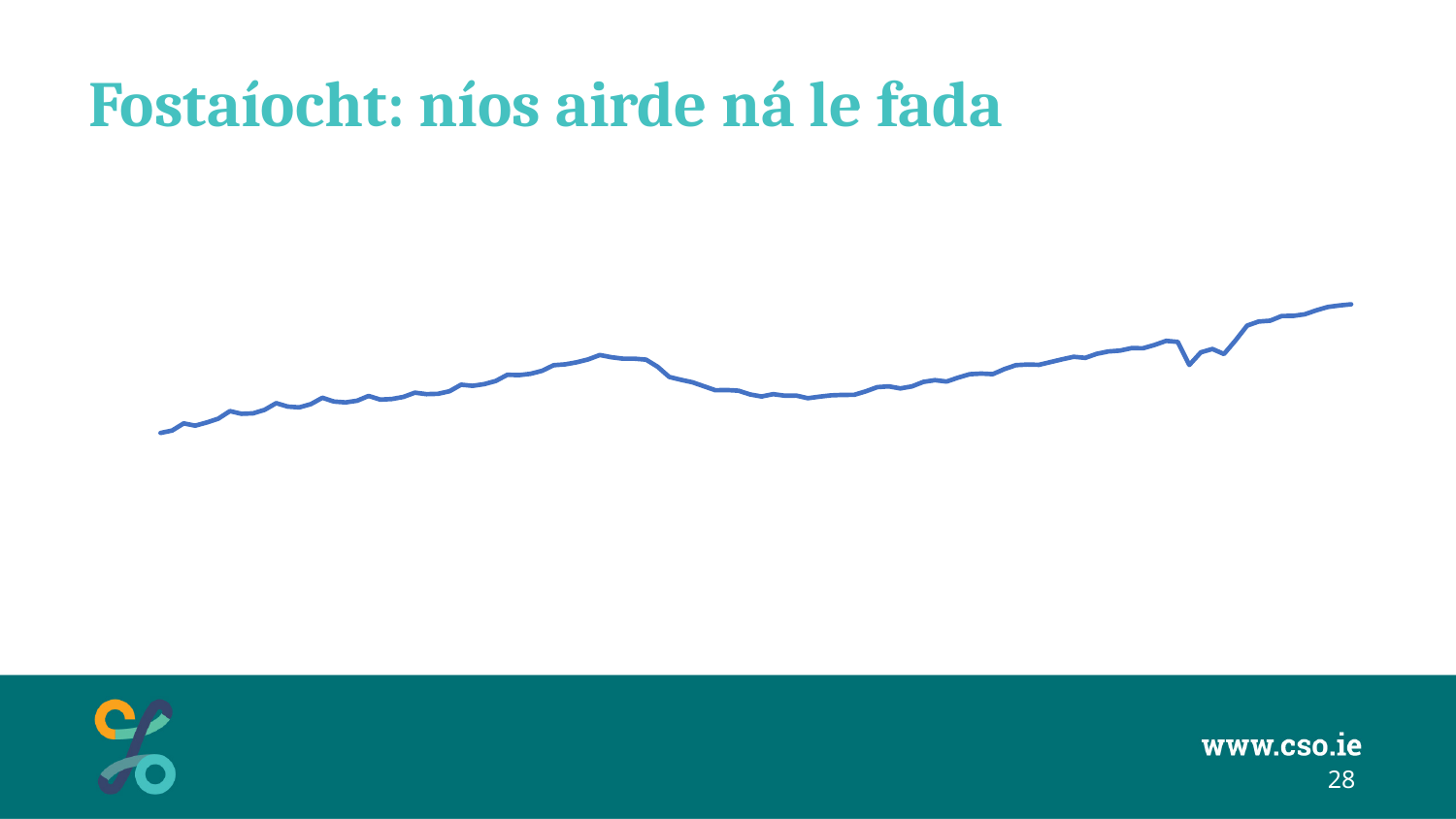
Is the right-hand end of the line higher or lower than its left-hand start? higher Is the lowest point of the line at the left-hand start or the right-hand end? left-hand start Does the line reach its highest point at the right-hand end or in the middle of the chart? right-hand end What is the title shown above the chart? Fostaíocht: níos airde ná le fada What kind of chart is shown on the slide? line chart How many lines are plotted on the chart? 1 Overall, does the line rise or fall from left to right? rise What colour is the plotted line? blue